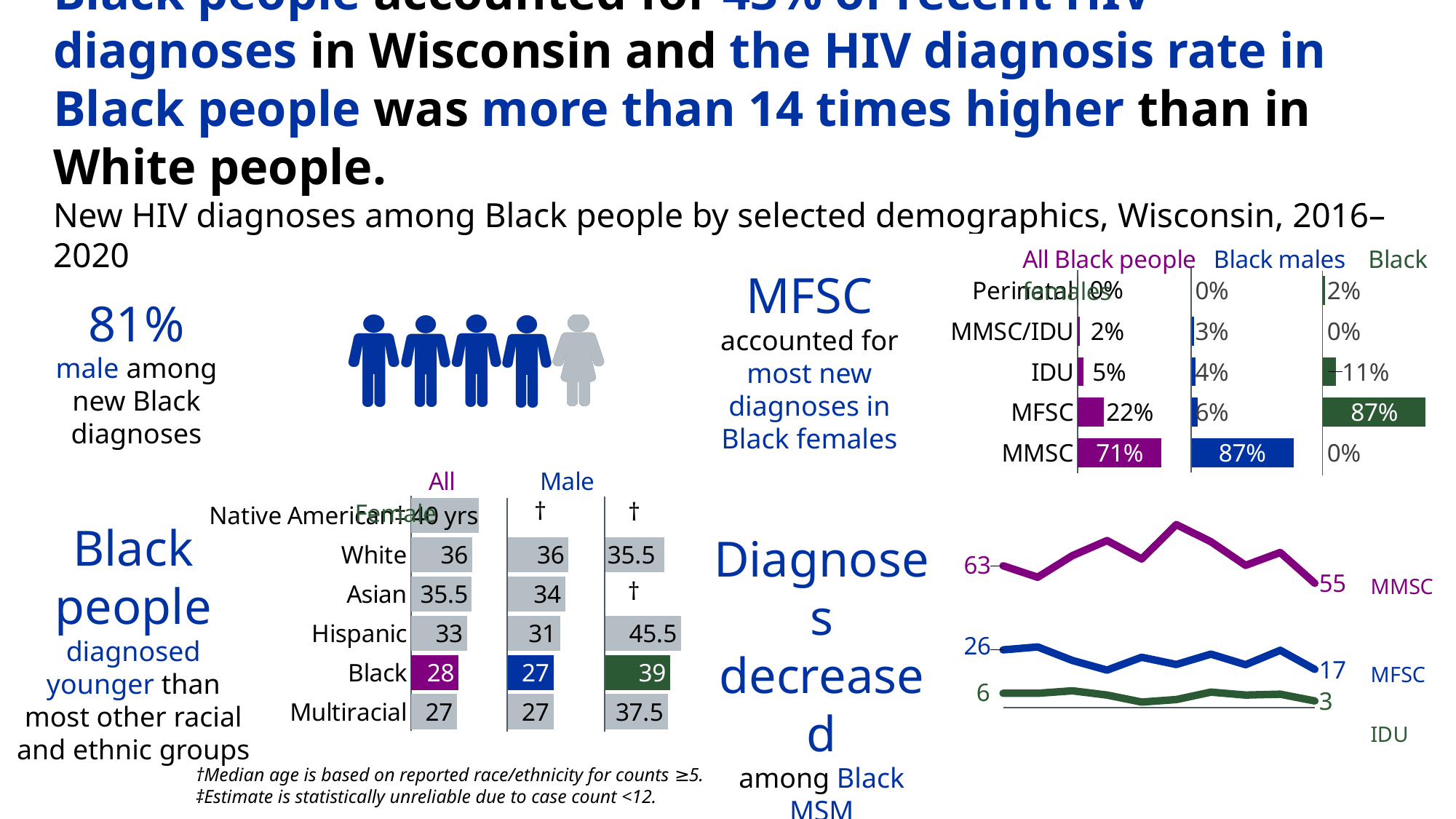
In the transmission category chart (top right), what percentage of All Black people is in the IDU category? 5% In the median age chart (bottom middle), which is higher for females: the median age for Black or for Hispanic? Hispanic In the median age chart (bottom middle), what is the median age for Hispanic females? 45.5 In the median age chart (bottom middle), what is the median age for Black males? 27 In the transmission category chart (top right), what is the difference between the MMSC percentage for Black males and for All Black people? 16 percentage points In the line chart (bottom right), what is the final value of the MMSC line? 55 In the transmission category chart (top right), what percentage of Black males is in the MMSC category? 87% In the transmission category chart (top right), what percentage of Black females is in the MFSC category? 87% How many series (column groups) does the transmission category chart (top right) show? 3 In the median age chart (bottom middle), which racial/ethnic group has the lowest median age in the All column? Multiracial In the transmission category chart (top right), which category is highest for All Black people? MMSC In the line chart (bottom right), does the MFSC line rise or fall from its first to its last point? fall